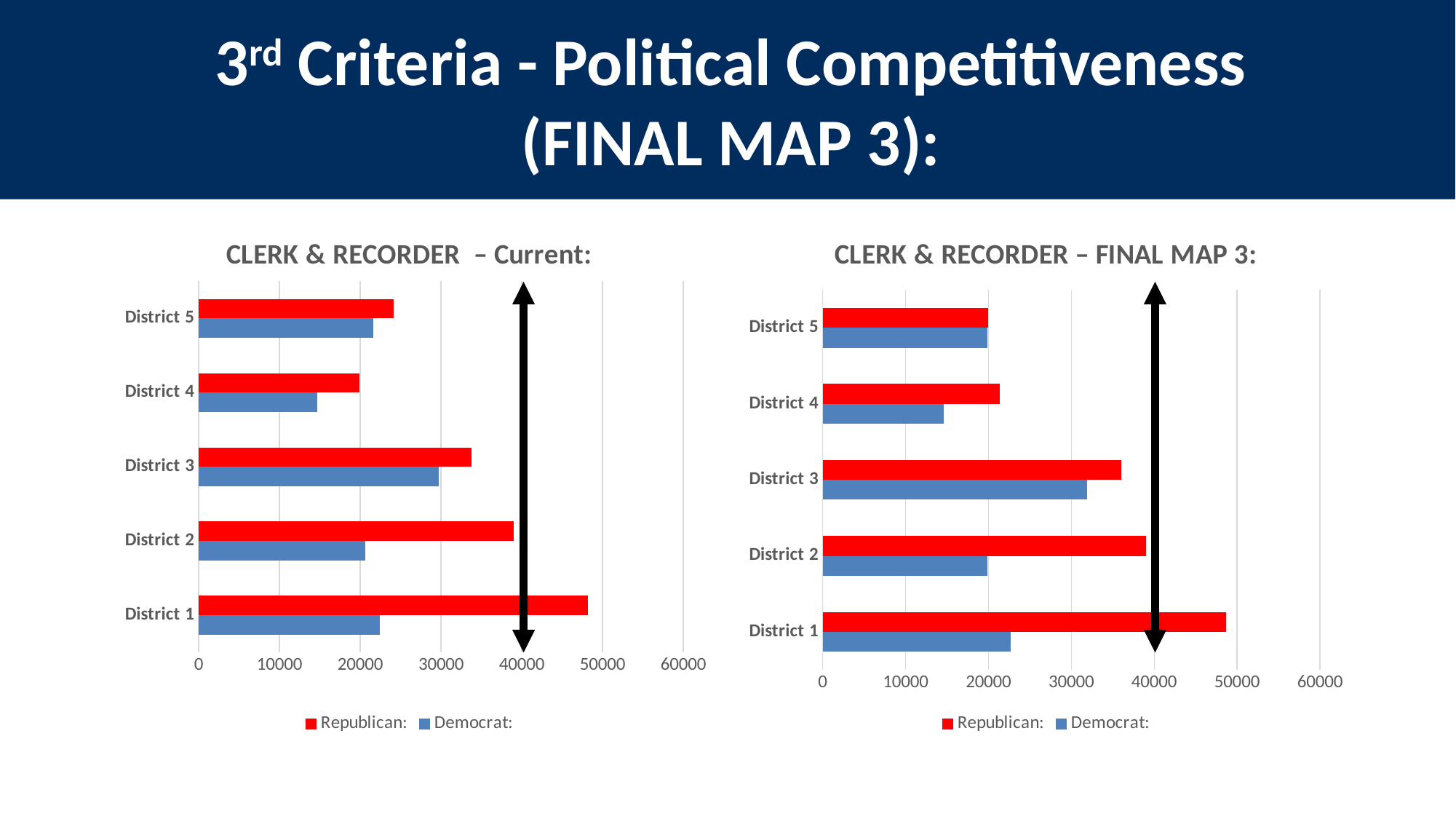
In the CLERK & RECORDER – FINAL MAP 3 chart, which district has the lowest Democrat value? District 4 In the CLERK & RECORDER – Current chart, which district has the lowest Democrat value? District 4 How many series does the legend of the CLERK & RECORDER – Current chart list? 2 In the CLERK & RECORDER – FINAL MAP 3 chart, which district has the highest Republican value? District 1 How many districts are shown in the CLERK & RECORDER – FINAL MAP 3 chart on the right? 5 In the CLERK & RECORDER – FINAL MAP 3 chart, is the Republican value for District 3 greater or less than 30000? greater In the CLERK & RECORDER – Current chart, which district has the highest Republican value? District 1 In the CLERK & RECORDER – Current chart, is the Republican value for District 1 greater or less than 40000? greater In the CLERK & RECORDER – Current chart, which is larger for District 2: the Republican value or the Democrat value? Republican What kind of chart is the CLERK & RECORDER – Current chart on the left? bar chart Which colour represents the Democrat series in the CLERK & RECORDER – FINAL MAP 3 chart? blue In the CLERK & RECORDER – FINAL MAP 3 chart, is the Democrat value for District 4 greater or less than 20000? less